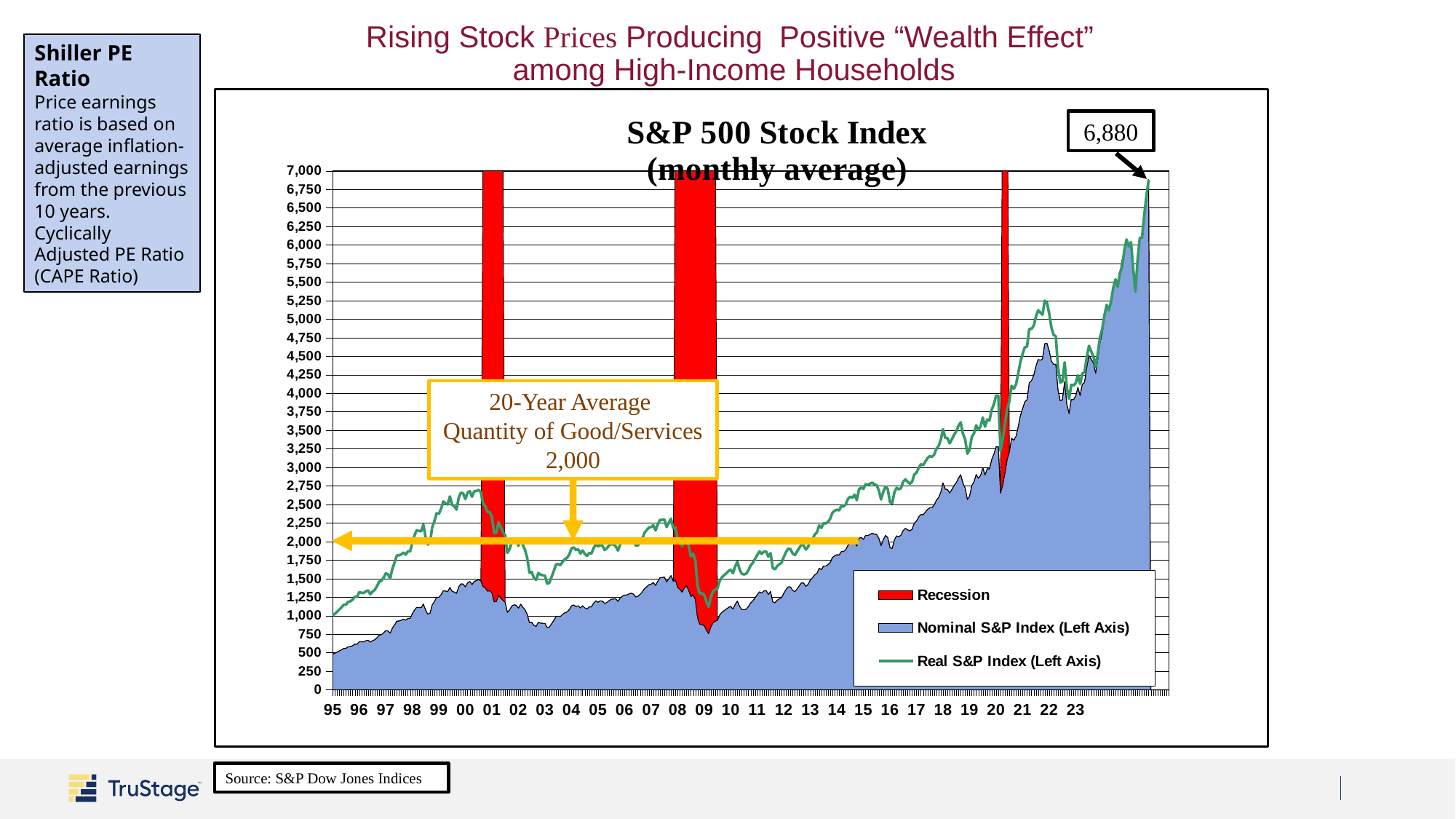
What colour marks the recession periods in the legend? Red Is the Real S&P Index at its 2000 peak greater or less than 2,500? greater How many recession periods are shaded on the chart? 3 What value is labelled at the end of the S&P 500 index series? 6,880 How many entries does the chart legend list? 3 Is the Real S&P Index at its 2009 low greater or less than 1,250? less Does the Nominal S&P Index generally rise or fall from 1995 to the end of the chart? rise What is the highest value shown on the left axis? 7,000 What is the 20-year average quantity of goods/services shown on the chart? 2,000 In 2021, which series is higher, the Nominal S&P Index or the Real S&P Index? Real S&P Index Is the Nominal S&P Index at its 2009 low greater or less than 1,000? less What is the title of the chart? S&P 500 Stock Index (monthly average)